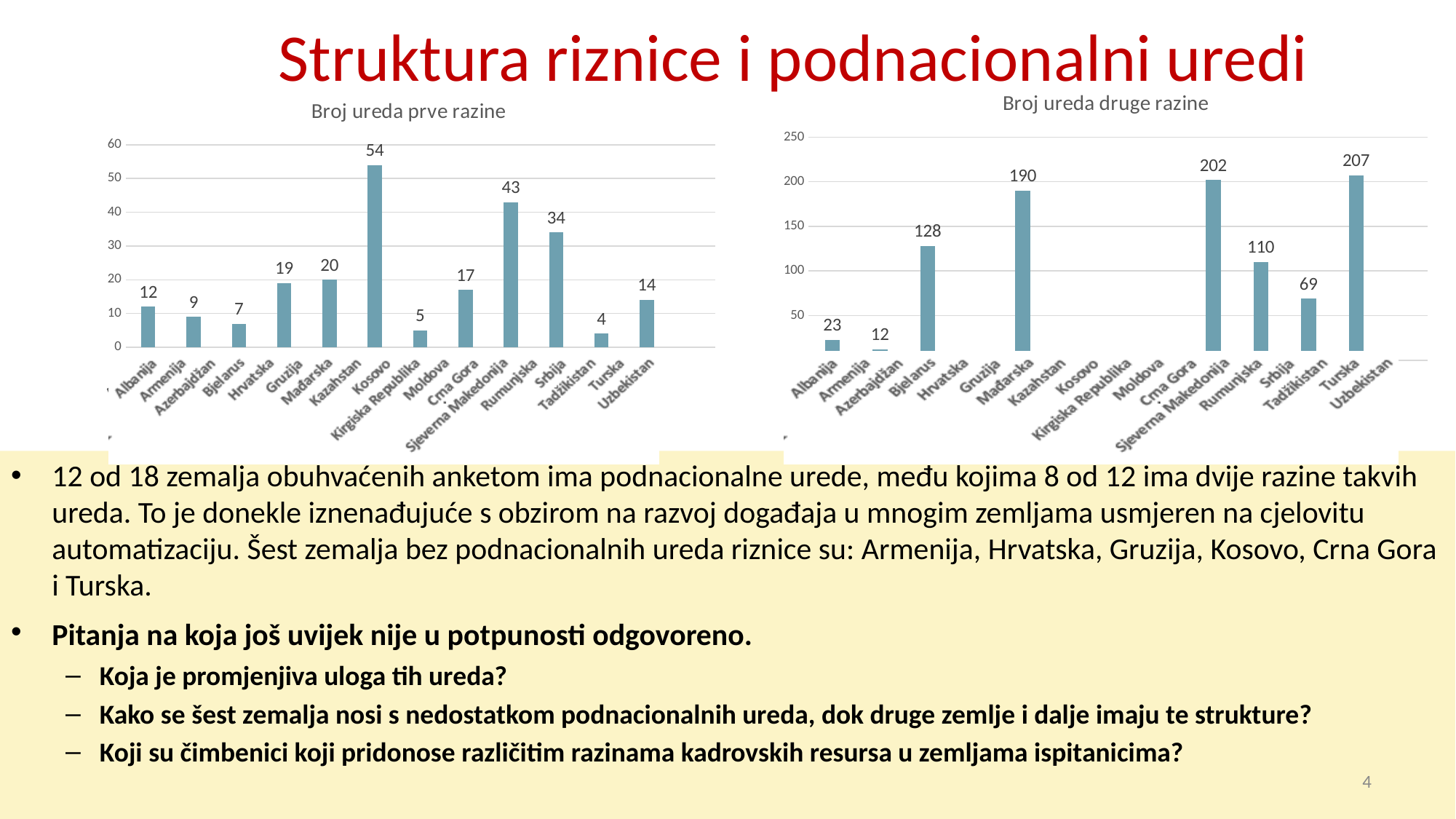
In the 'Broj ureda druge razine' chart, what is the highest value shown? 207 In the 'Broj ureda prve razine' chart, what is the lowest value shown? 4 How many bars are plotted in the 'Broj ureda druge razine' chart? 8 In the 'Broj ureda druge razine' chart, what is the value for Albanija? 23 In the 'Broj ureda prve razine' chart, what is the value for Albanija? 12 How many bars are plotted in the 'Broj ureda prve razine' chart? 12 What type of chart is used for 'Broj ureda prve razine'? Bar chart In the 'Broj ureda prve razine' chart, what is the highest value shown? 54 In the 'Broj ureda druge razine' chart, what is the lowest value shown? 12 What is the title of the chart on the right side of the slide? Broj ureda druge razine In the 'Broj ureda prve razine' chart, what is the difference between the highest value (54) and the lowest value (4)? 50 In the 'Broj ureda druge razine' chart, what is the difference between the highest value (207) and the lowest value (12)? 195